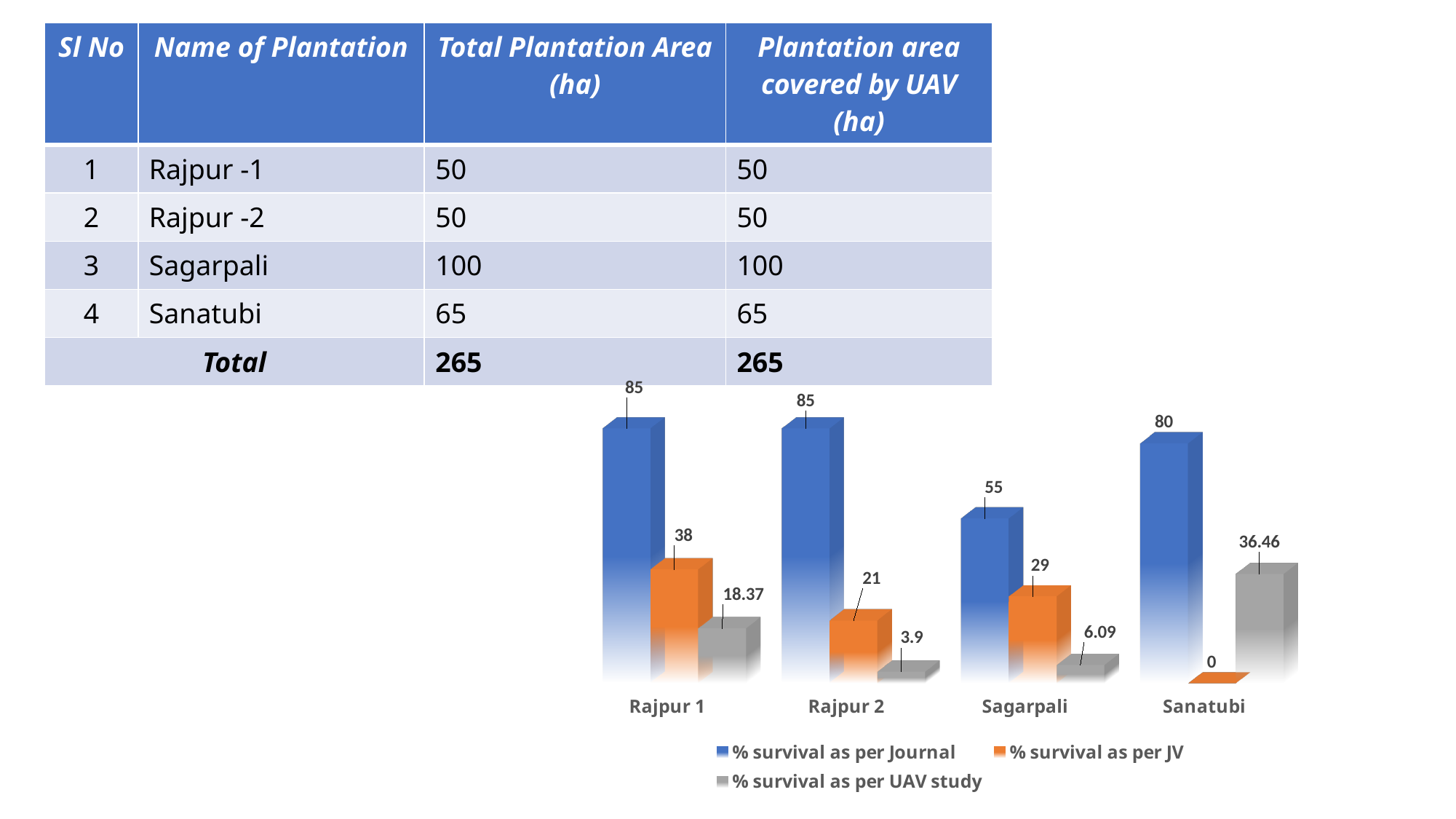
Which is larger for Sagarpali: % survival as per JV or % survival as per UAV study? % survival as per JV How many series does the chart legend list? 3 Which plantation has the highest % survival as per UAV study? Sanatubi What is the % survival as per JV for Sagarpali? 29 What is the % survival as per Journal for Rajpur 1? 85 What is the % survival as per UAV study for Rajpur 2? 3.9 How many plantations are shown on the x axis of the chart? 4 What is the % survival as per UAV study for Sanatubi? 36.46 Which plantation has the lowest % survival as per Journal? Sagarpali What kind of chart is shown on the slide? Bar chart Which plantation has the lowest % survival as per JV? Sanatubi What is the difference between the % survival as per JV and the % survival as per UAV study for Rajpur 2? 17.1